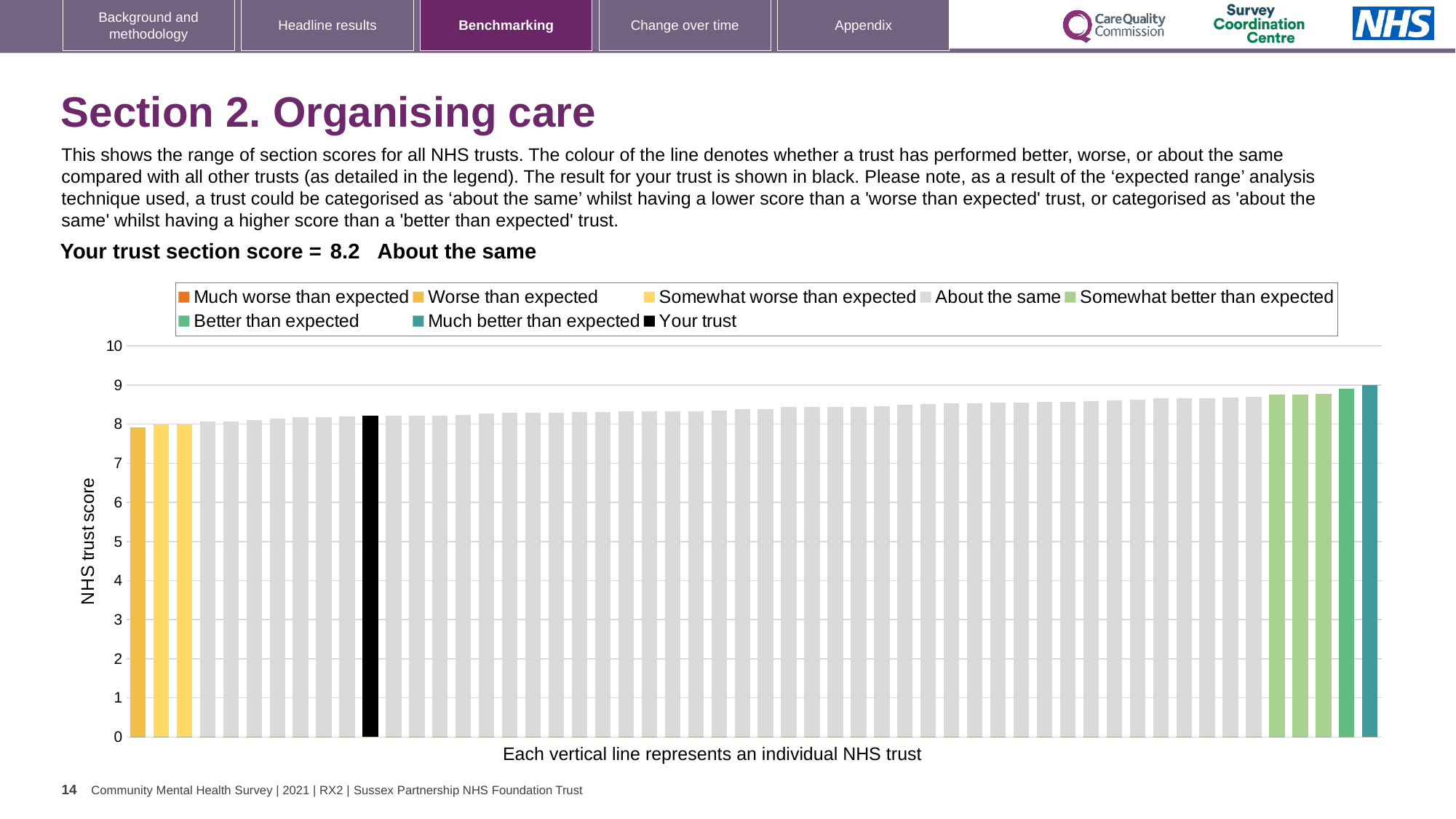
Is the value of the black 'Your trust' bar greater or less than 8? greater What is the section score for your trust (the black bar)? 8.2 Do the bar values rise or fall from left to right along the x axis? Rise Which legend category does the tallest bar belong to? Much better than expected Which legend category does the shortest bar belong to? Worse than expected Is the value of the rightmost bar greater or less than 8? greater What colour is used in the chart to show your trust? Black Which is larger: the value of the black 'Your trust' bar or the value of the leftmost bar? The black 'Your trust' bar How many entries does the chart legend list? 8 What is the label on the vertical axis of the chart? NHS trust score What kind of chart is shown on the slide? Bar chart